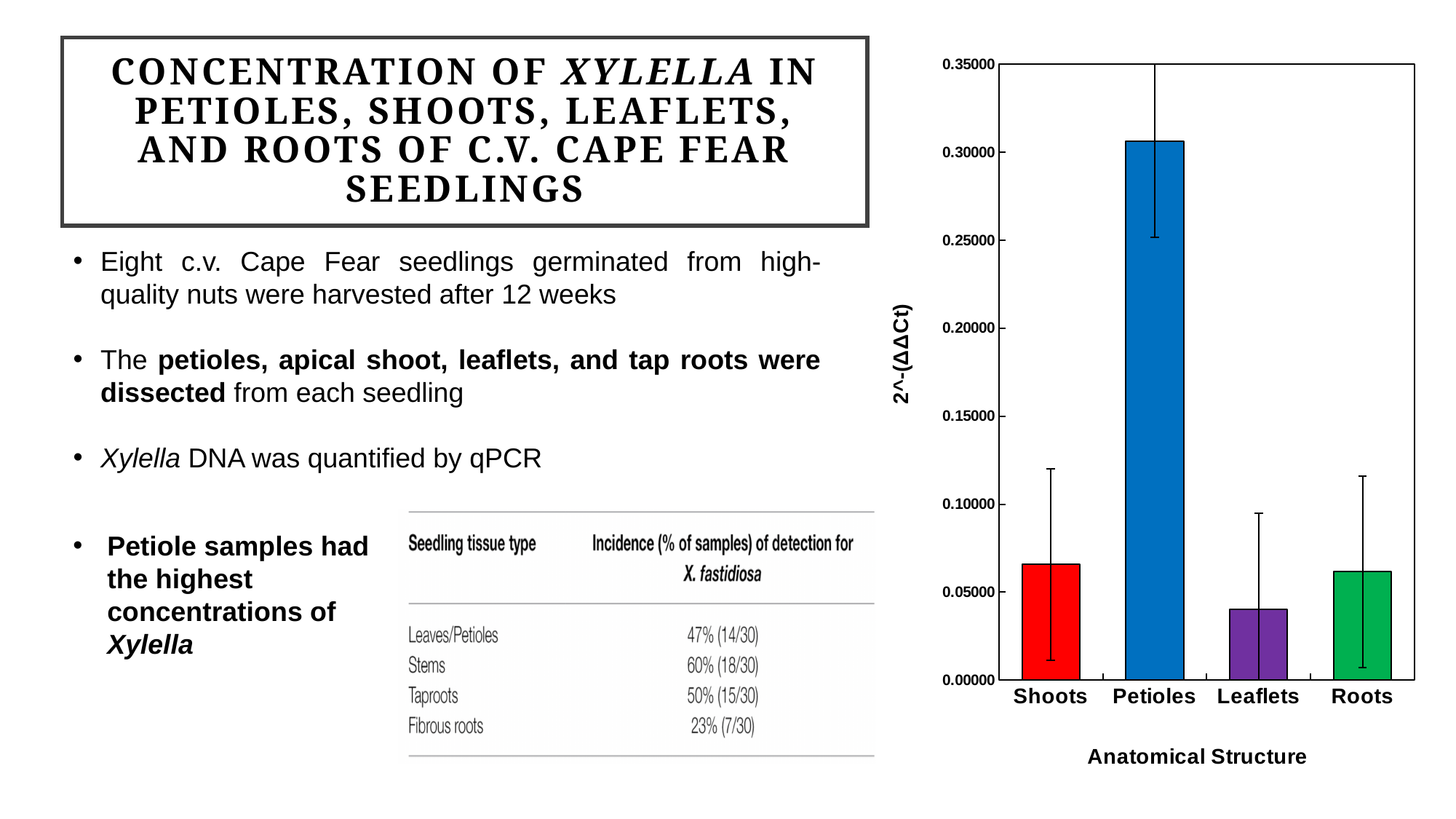
In the bar chart, which has the larger value, Petioles or Leaflets? Petioles What kind of chart is shown on the right side of the slide? bar chart Which anatomical structure has the highest 2^-(ΔΔCt) value in the bar chart? Petioles What colour is the Petioles bar in the bar chart? blue What is the x-axis title of the bar chart? Anatomical Structure In the bar chart, is the value for Shoots greater or less than 0.10000? less In the bar chart, which has the larger value, Shoots or Leaflets? Shoots In the bar chart, is the value for Leaflets greater or less than 0.05000? less In the bar chart, is the value for Petioles greater or less than 0.25000? greater Which anatomical structure has the lowest 2^-(ΔΔCt) value in the bar chart? Leaflets How many anatomical structures are plotted on the x axis of the bar chart? 4